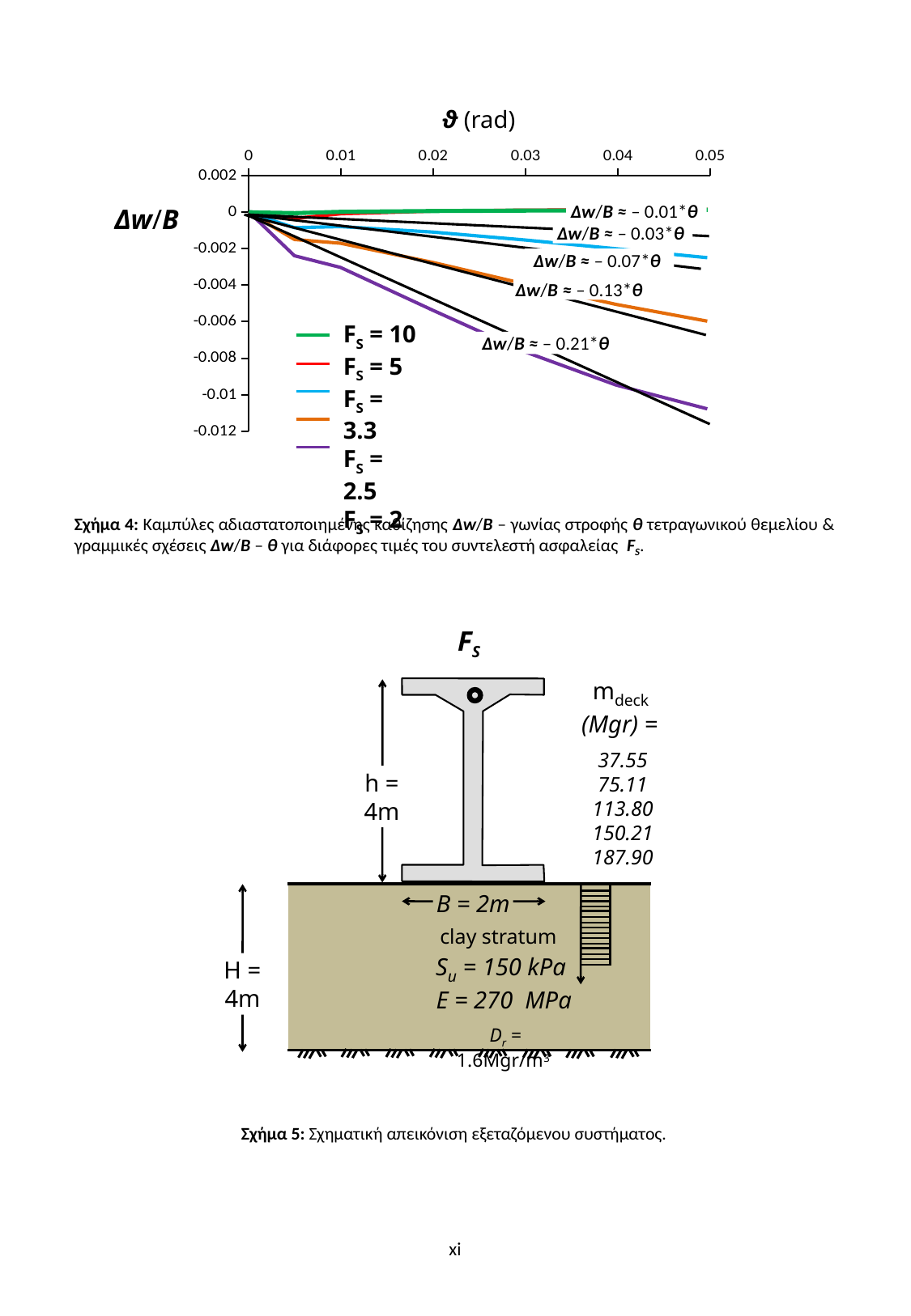
In the Δw/B – θ chart, is the Δw/B value for Fs = 5 at θ = 0.05 greater or less than -0.004? greater What is the label of the horizontal axis of the Δw/B – θ chart? ϑ (rad) Which series in the Δw/B – θ chart reaches the lowest Δw/B value at θ = 0.05? Fs = 2 How many series does the legend of the Δw/B – θ chart list? 5 In the Δw/B – θ chart, do the Δw/B values for Fs = 2 rise or fall as θ increases? fall In the Δw/B – θ chart, is the Δw/B value for Fs = 3.3 at θ = 0.05 greater or less than -0.008? greater How many tick marks are labelled on the θ axis of the Δw/B – θ chart? 6 In the Δw/B – θ chart, is the Δw/B value for Fs = 3.3 at θ = 0.05 greater or less than -0.004? greater In the Δw/B – θ chart, at θ = 0.05, which series has the larger Δw/B value, Fs = 10 or Fs = 2? Fs = 10 What kind of chart is shown in Figure 4 (Σχήμα 4)? line chart Which series in the Δw/B – θ chart stays closest to zero (highest Δw/B) across the θ range? Fs = 10 What linear relation is annotated next to the steepest line in the Δw/B – θ chart? Δw/B ≈ – 0.21*θ